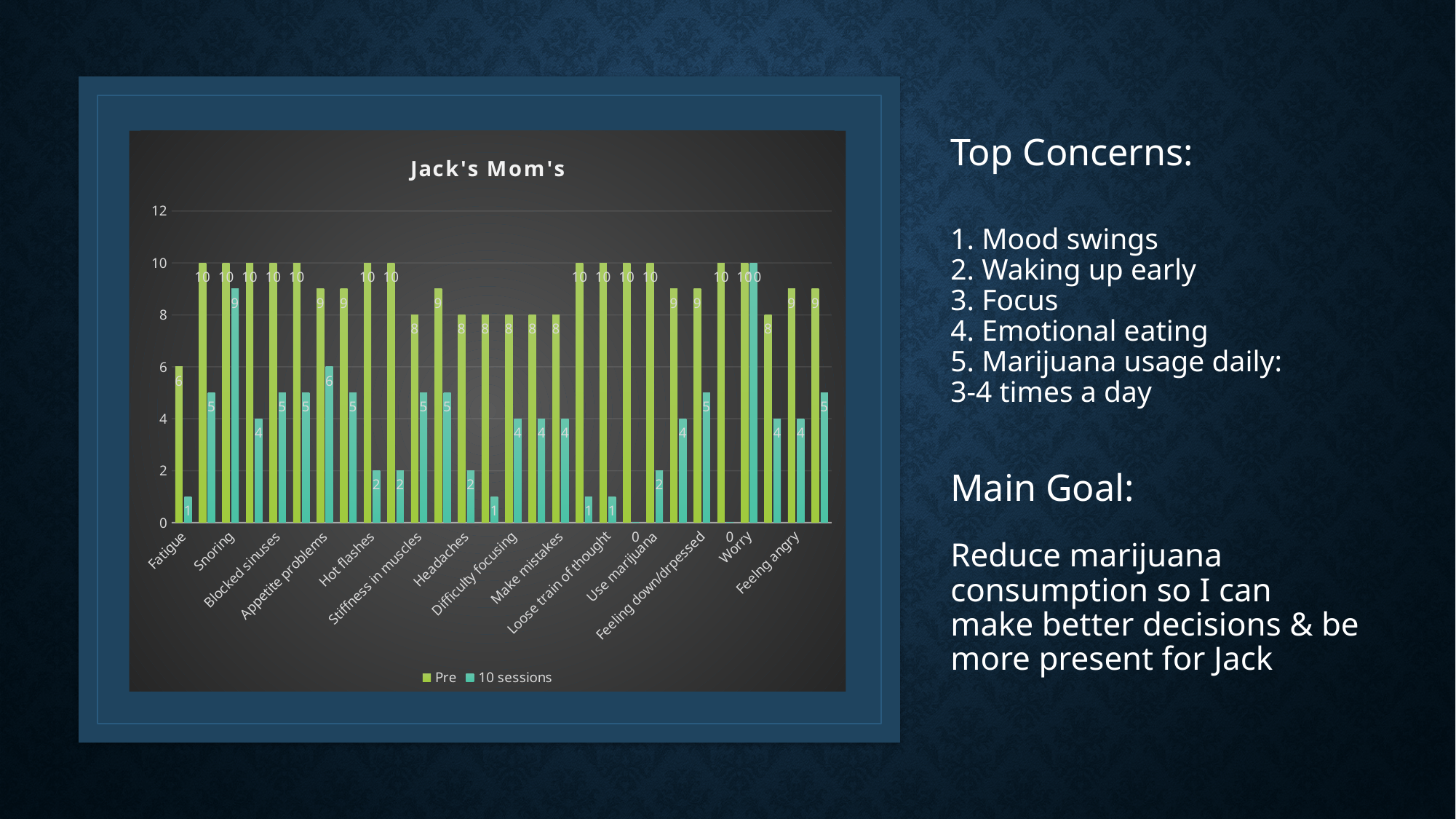
What is the title of the chart? Jack's Mom's What is the difference between the Pre and 10 sessions values for Fatigue? 5 How many series does the chart legend list? 2 What are the two series named in the chart legend? Pre and 10 sessions Is the Pre value for Fatigue greater or less than 4? greater What is the 10 sessions value for Fatigue? 1 What is the Pre value for Fatigue? 6 Is the 10 sessions value for Fatigue greater or less than 2? less What kind of chart is shown on the slide? bar chart What is the Pre value for Snoring? 10 What is the 10 sessions value for Snoring? 9 For Fatigue, which series has the larger value, Pre or 10 sessions? Pre